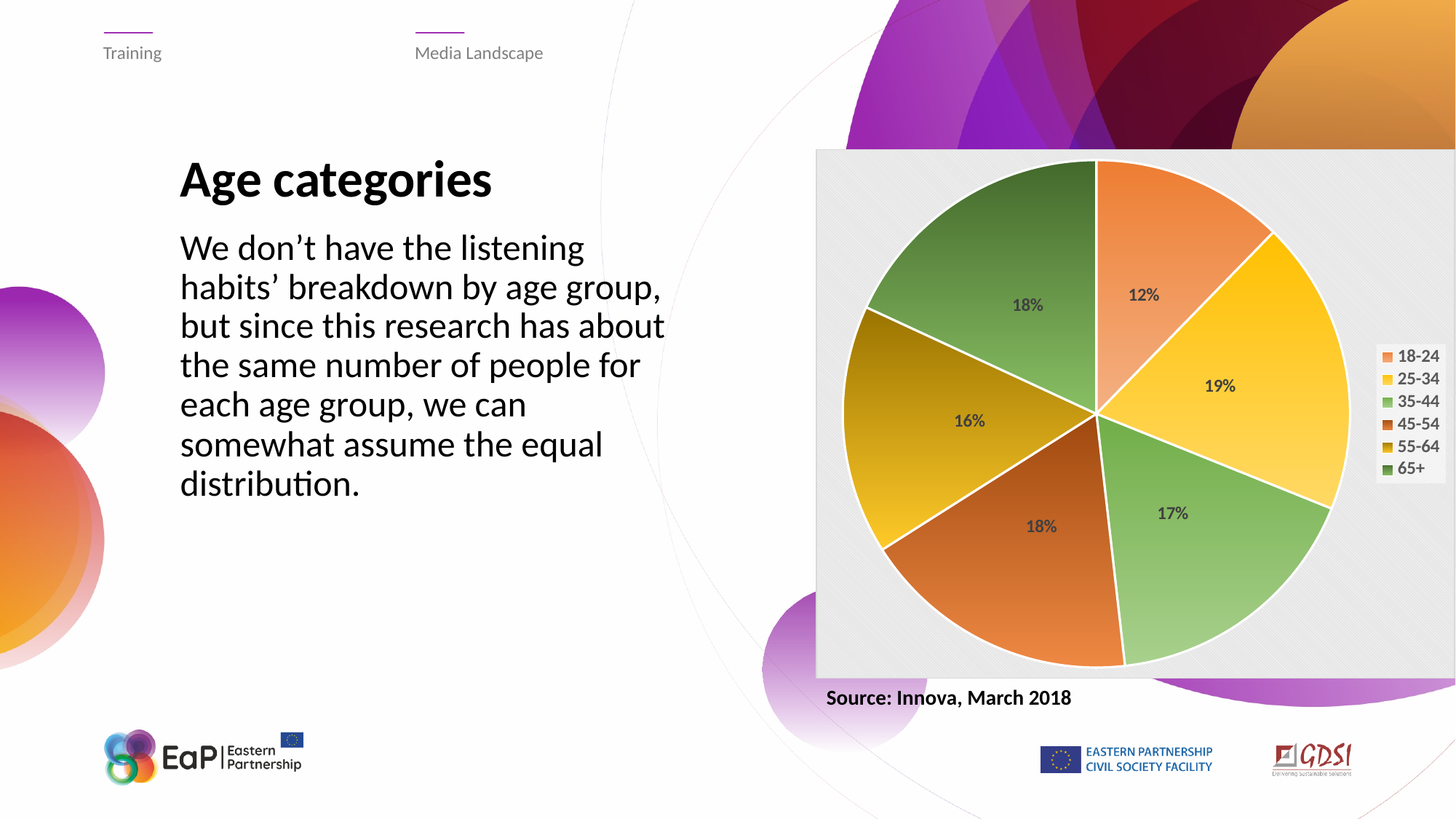
What percentage is shown for the 55-64 age group? 16% What source is cited below the chart? Innova, March 2018 What is the value for the 65+ age group? 18% What is the value for the 35-44 age group? 17% Which age group has the largest share of the pie? 25-34 What share of the pie does the 18-24 age group represent? 12% What is the difference between the shares of the 25-34 and 18-24 age groups? 7% What type of chart is shown on the slide? Pie chart What percentage is shown for the 25-34 age group? 19% How many age groups are shown in the pie chart? 6 Which age group has the smallest share of the pie? 18-24 Which is larger, the share for 35-44 or the share for 55-64? 35-44